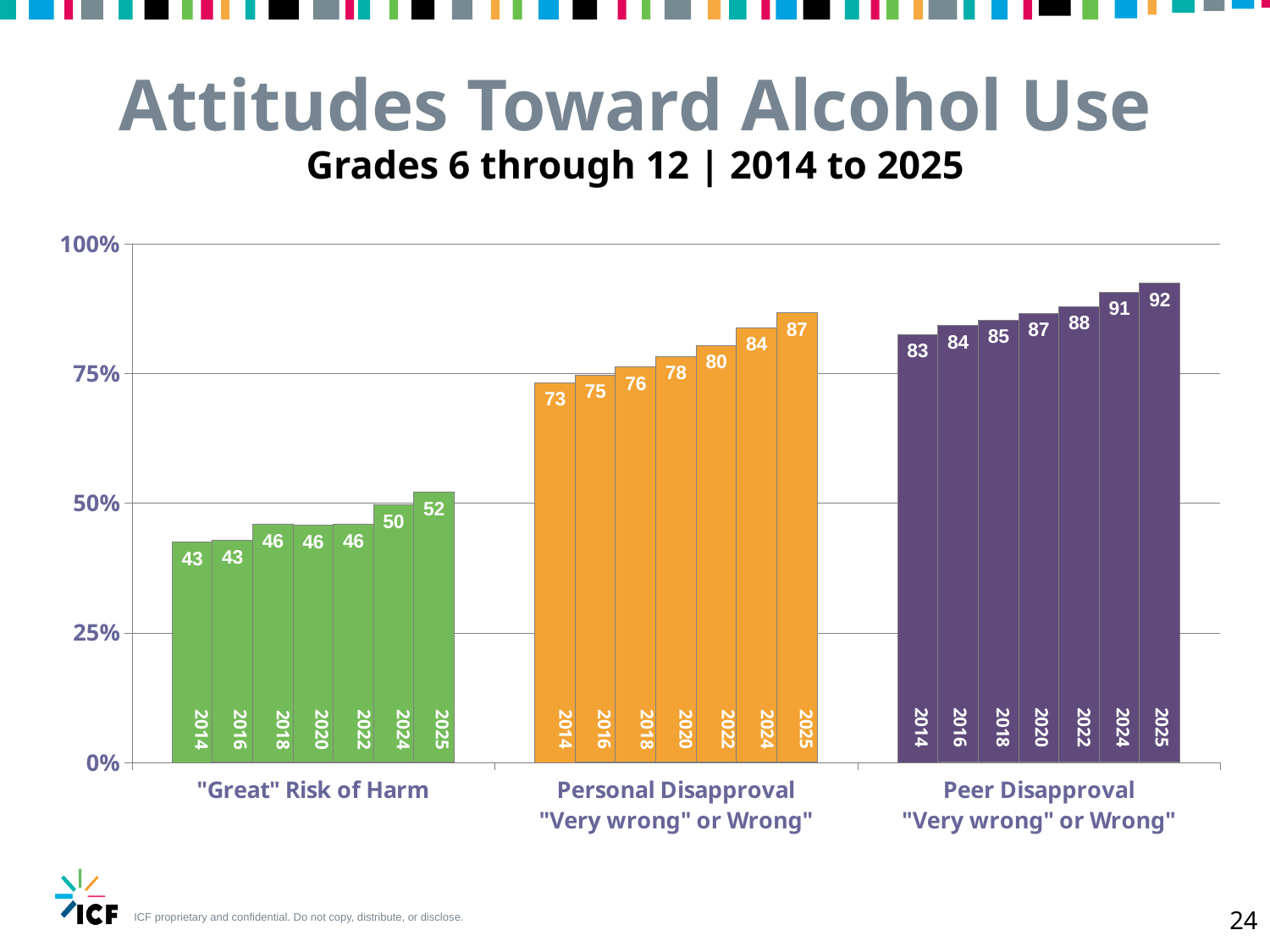
Which year has the highest value for Peer Disapproval? 2025 Which year has the lowest value for Personal Disapproval? 2014 What is the value for Peer Disapproval in 2020? 87 What kind of chart is shown on the slide? Bar chart Which is larger: Peer Disapproval in 2014 or Personal Disapproval in 2025? Personal Disapproval in 2025 Is the value for "Great" Risk of Harm in 2024 greater or less than 25%? greater What is the value for "Great" Risk of Harm in 2025? 52 What is the value for Personal Disapproval in 2014? 73 How many years are shown for each of the three groups? 7 Do the Peer Disapproval values rise or fall from 2014 to 2025? Rise What colour are the bars for Personal Disapproval? Orange What is the difference between the Personal Disapproval values for 2025 and 2014? 14